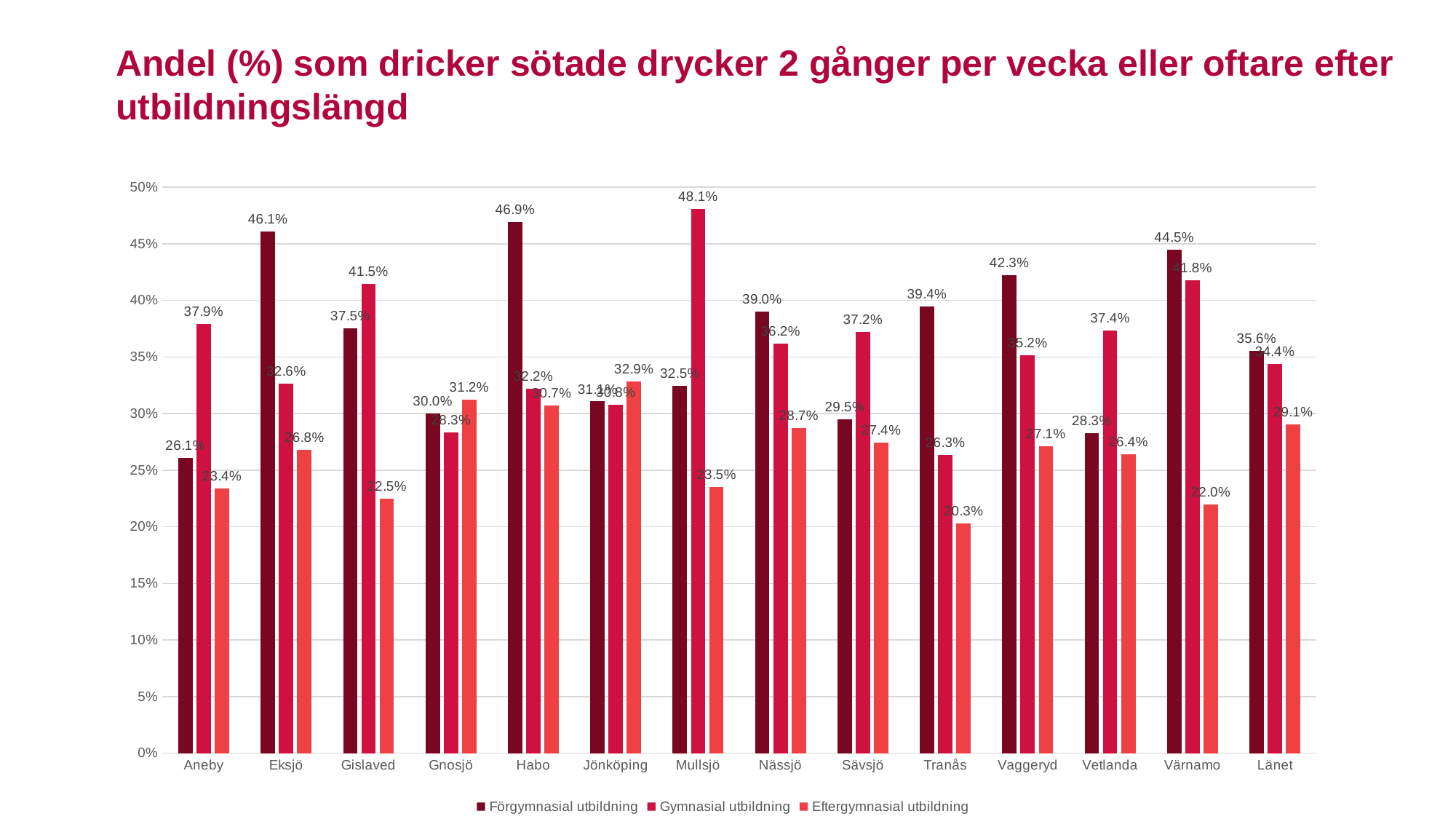
Which is larger in Gislaved: the Förgymnasial utbildning value or the Gymnasial utbildning value? Gymnasial utbildning How many categories are shown on the x axis? 14 Which municipality has the highest value for Gymnasial utbildning? Mullsjö What is the value for Gymnasial utbildning in Länet? 34.4% What is the title of the chart? Andel (%) som dricker sötade drycker 2 gånger per vecka eller oftare efter utbildningslängd What kind of chart is shown on the slide? Bar chart Which category has the lowest value for Eftergymnasial utbildning? Tranås What is the value for Eftergymnasial utbildning in Tranås? 20.3% What is the difference between the Förgymnasial utbildning and Gymnasial utbildning values in Eksjö? 13.5 percentage points How many series does the legend list? 3 Is the value for Gymnasial utbildning in Mullsjö greater or less than 45%? greater What is the value for Förgymnasial utbildning in Habo? 46.9%